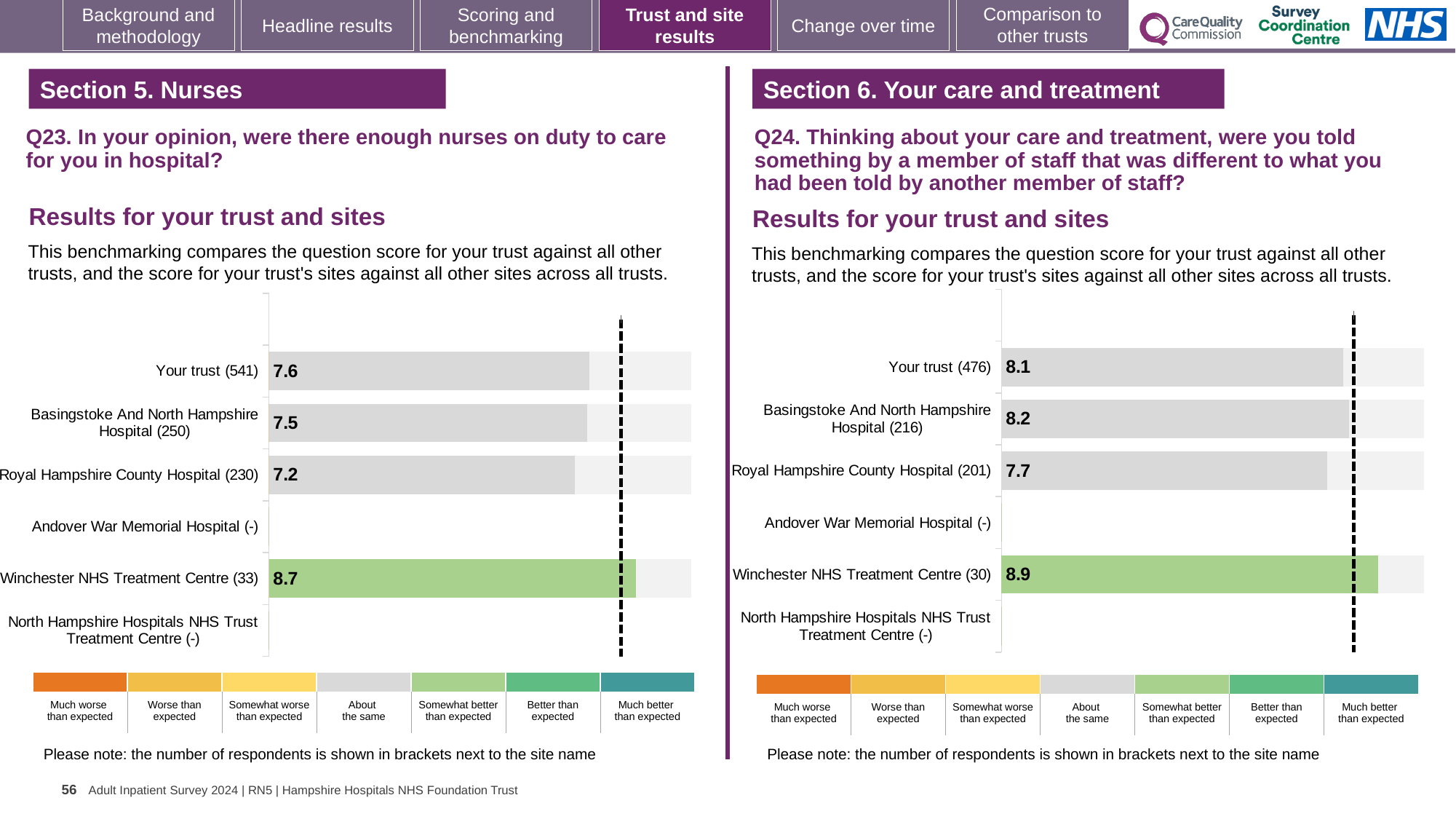
In the Q23 chart on the left, how many respondents are shown for Basingstoke And North Hampshire Hospital? 250 In the Q24 chart on the right, what is the score for Winchester NHS Treatment Centre? 8.9 What type of chart is used in the Q23 chart on the left? Bar chart In the Q23 chart on the left, which site with a score shown has the lowest score? Royal Hampshire County Hospital In the Q23 chart on the left, which site has the highest score? Winchester NHS Treatment Centre In the Q24 chart on the right, what is the difference between the scores for Basingstoke And North Hampshire Hospital and Royal Hampshire County Hospital? 0.5 In the Q24 chart on the right, which is larger, the score for Your trust or the score for Royal Hampshire County Hospital? Your trust In the Q23 chart on the left, what is the difference between the scores for Winchester NHS Treatment Centre and Your trust? 1.1 In the Q24 chart on the right, what is the score for Basingstoke And North Hampshire Hospital? 8.2 In the Q23 chart on the left, what is the score for Royal Hampshire County Hospital? 7.2 In the Q24 chart on the right, how many sites or trust rows have a score bar shown? 4 In the Q23 chart on the left, what is the score for Your trust? 7.6